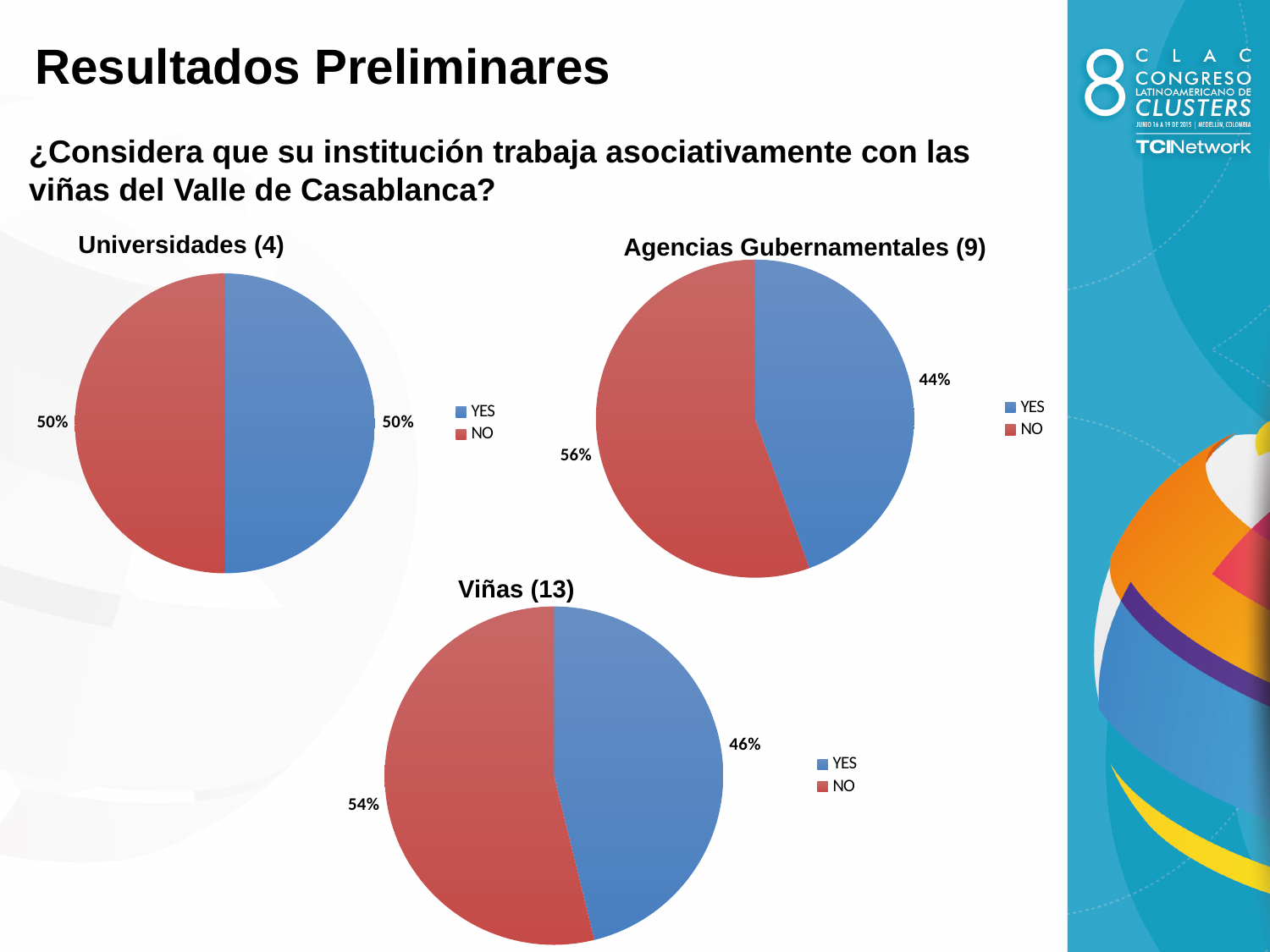
In the 'Agencias Gubernamentales (9)' chart, what is the difference between the NO and YES shares? 12% How many slices does the 'Viñas (13)' chart have? 2 In the 'Viñas (13)' chart, what share of the pie is NO? 54% How many entries does the legend of the 'Agencias Gubernamentales (9)' chart list? 2 In the 'Universidades (4)' chart, what share of the pie is YES? 50% In the 'Agencias Gubernamentales (9)' chart, which category has the largest slice? NO In the 'Viñas (13)' chart, what is the difference between the NO and YES shares? 8% In the 'Agencias Gubernamentales (9)' chart, what is the value for YES? 44% What kind of chart is the 'Universidades (4)' chart? Pie chart In the 'Agencias Gubernamentales (9)' chart, what share of the pie is NO? 56% In the 'Viñas (13)' chart, what is the value for YES? 46% In the 'Viñas (13)' chart, which slice is larger, YES or NO? NO